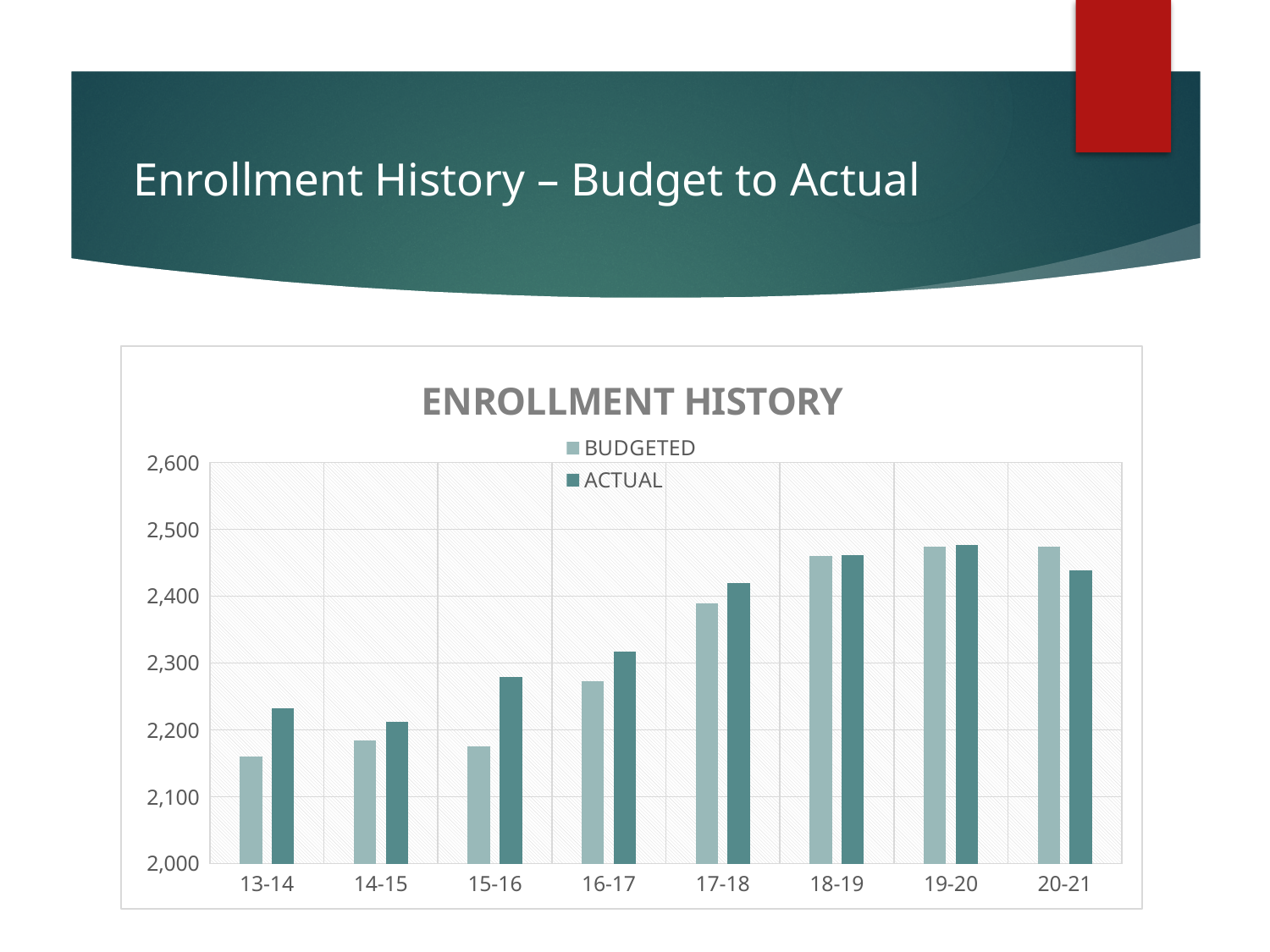
Is the BUDGETED value for 13-14 greater or less than 2,200? less What is the title of the chart on the slide? ENROLLMENT HISTORY How many series does the legend of the Enrollment History chart list? 2 What type of chart is shown on the slide? Bar chart Is the ACTUAL value for 13-14 greater or less than 2,200? greater Is the ACTUAL value for 17-18 greater or less than 2,400? greater How many school years are shown on the x axis of the Enrollment History chart? 8 For 15-16, which is larger, the BUDGETED value or the ACTUAL value? ACTUAL For 20-21, which is larger, the BUDGETED value or the ACTUAL value? BUDGETED What are the two series named in the legend of the Enrollment History chart? BUDGETED and ACTUAL